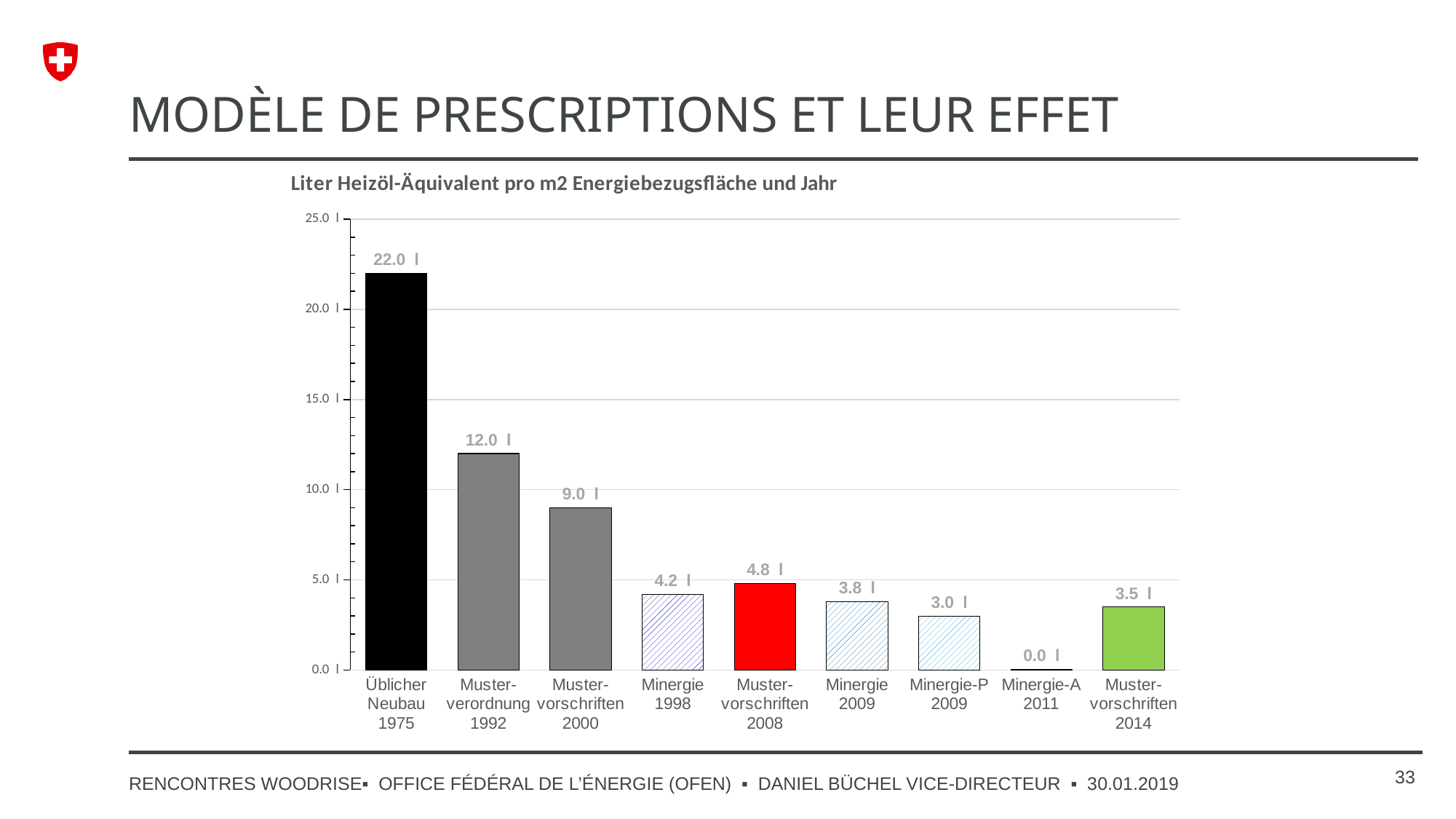
Is the value for Mustervorschriften 2000 greater or less than 10.0 l? less What is the value for Mustervorschriften 2014? 3.5 l Which category has the highest value? Üblicher Neubau 1975 What is the difference between the values for Musterverordnung 1992 and Mustervorschriften 2000? 3.0 l What is the title of the chart? Liter Heizöl-Äquivalent pro m2 Energiebezugsfläche und Jahr What kind of chart is shown on the slide? bar chart What is the value for Minergie 1998? 4.2 l What is the value for Üblicher Neubau 1975? 22.0 l Which is larger, the value for Mustervorschriften 2008 or the value for Minergie 2009? Mustervorschriften 2008 Which category has the lowest value? Minergie-A 2011 What is the value for Musterverordnung 1992? 12.0 l How many categories are shown on the x axis? 9